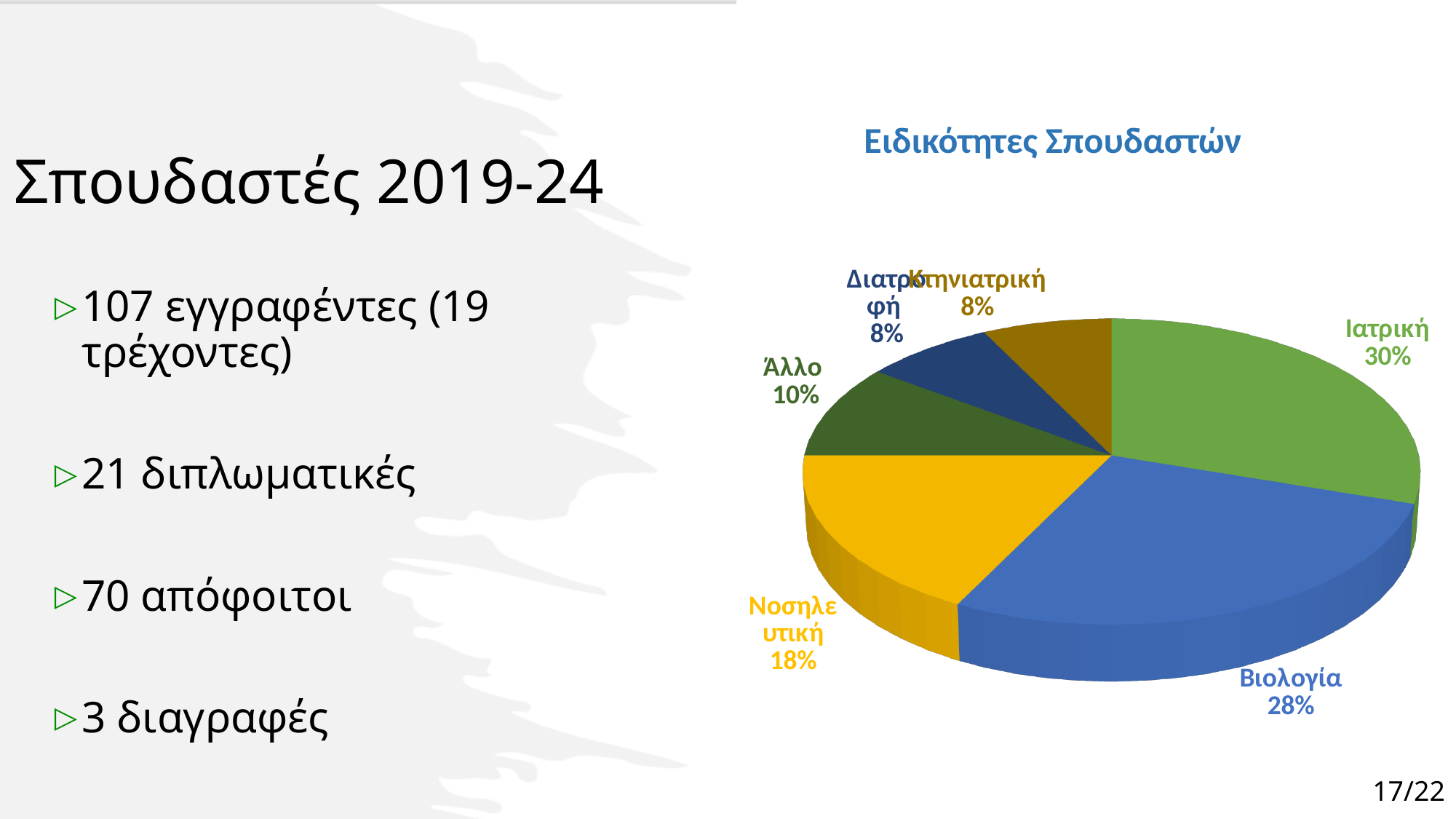
How many slices does the pie chart have? 6 What percentage of the pie does Βιολογία represent? 28% What type of chart is shown on the slide? pie chart What is the difference in percentage points between Ιατρική and Βιολογία? 2 What percentage of the pie does Ιατρική represent? 30% What is the title of the chart? Ειδικότητες Σπουδαστών What percentage of the pie does Κτηνιατρική represent? 8% Which category has the largest share of the pie? Ιατρική Which is larger, the share for Νοσηλευτική or the share for Άλλο? Νοσηλευτική What percentage of the pie does Άλλο represent? 10% What percentage of the pie does Νοσηλευτική represent? 18% What colour is the Βιολογία slice? blue